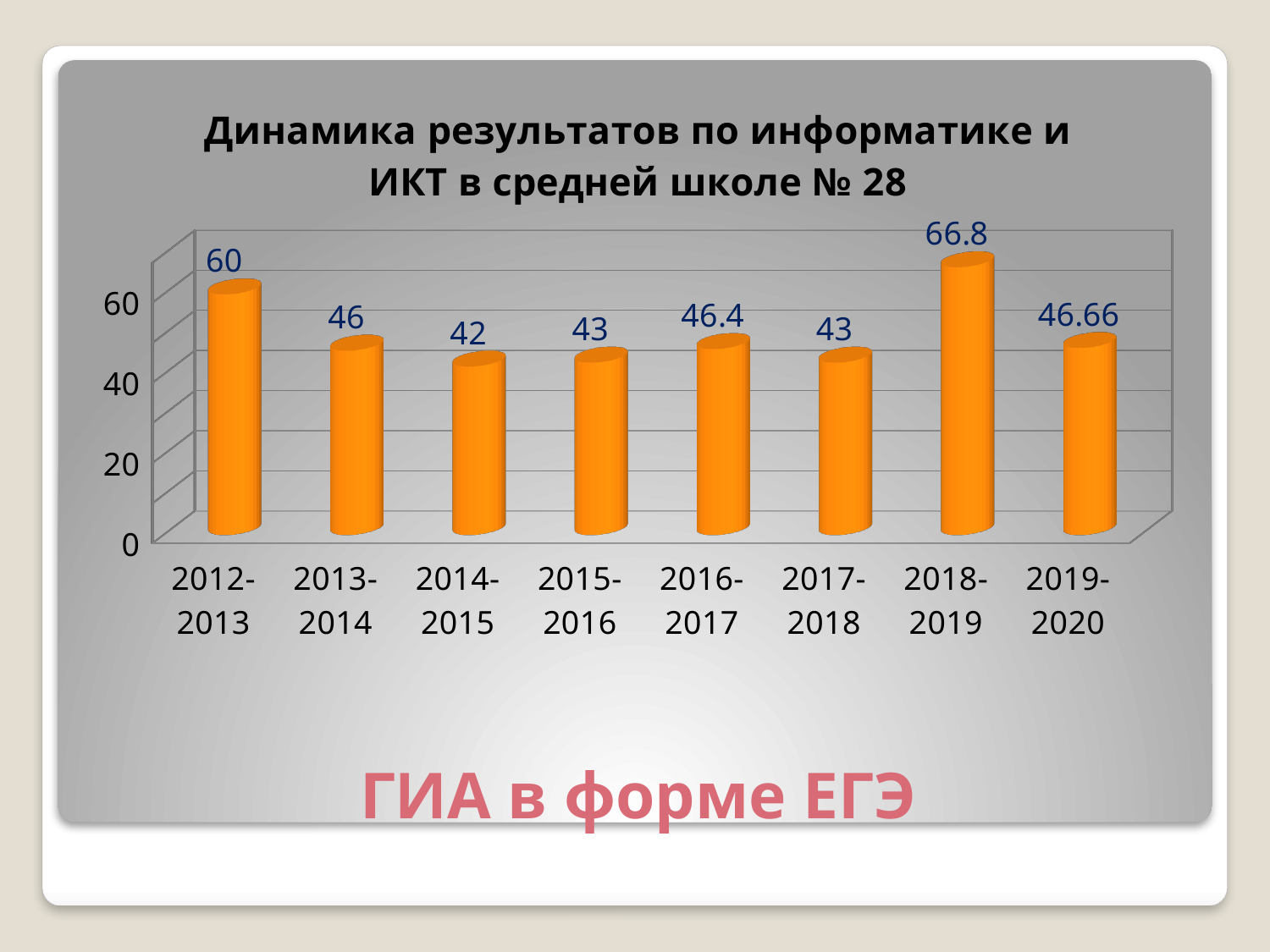
What is the value for 2016-2017? 46.4 Which year has the highest value? 2018-2019 What is the value for 2019-2020? 46.66 Which is larger, the value for 2016-2017 or the value for 2017-2018? 2016-2017 What is the value for 2018-2019? 66.8 Which year has the lowest value? 2014-2015 What is the difference between the values for 2018-2019 and 2012-2013? 6.8 What is the difference between the values for 2013-2014 and 2014-2015? 4 How many years are shown on the chart? 8 What is the value for 2012-2013? 60 What is the title of the chart? Динамика результатов по информатике и ИКТ в средней школе № 28 What kind of chart is this? bar chart